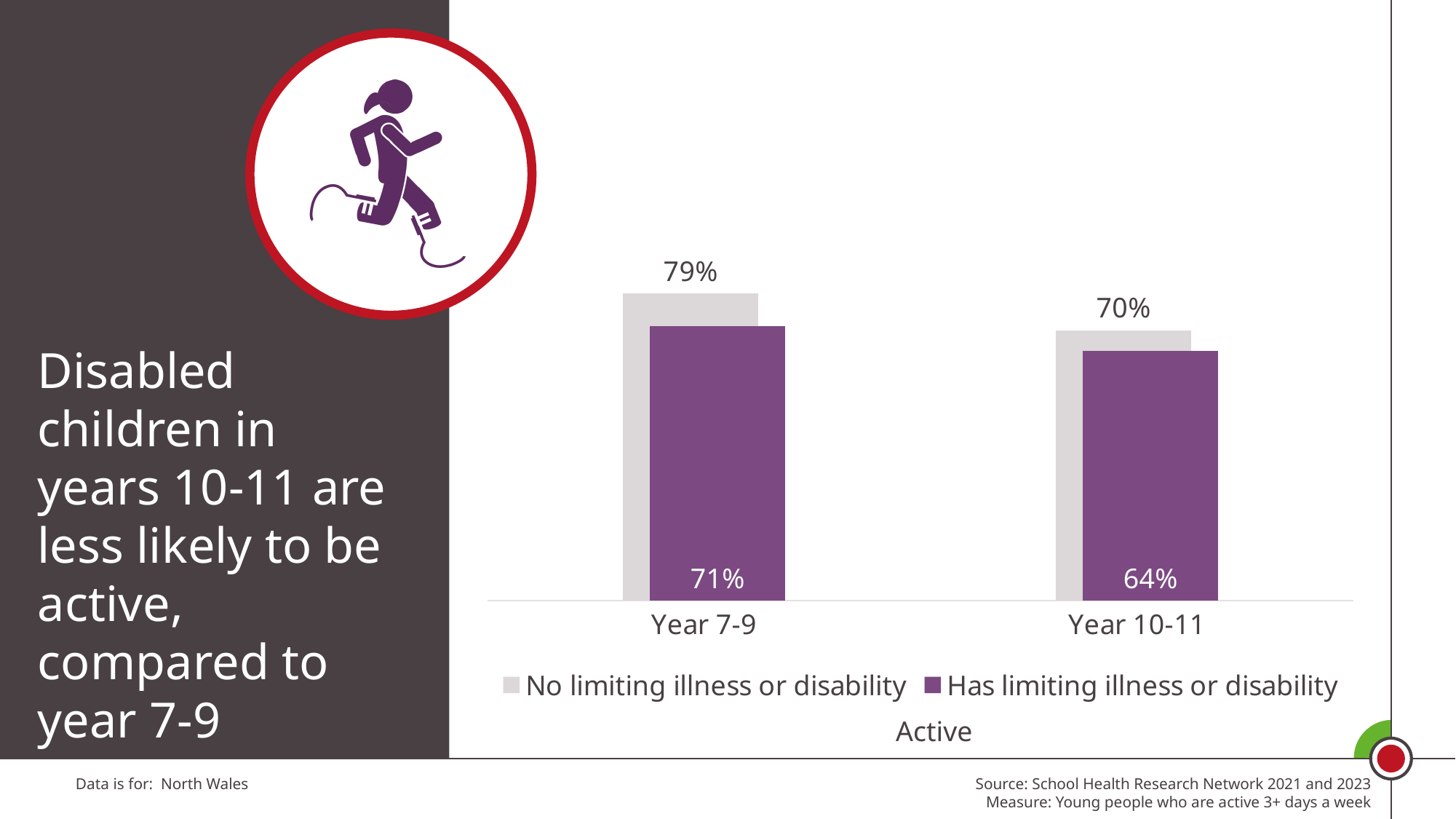
How many categories are shown on the x axis? 2 What kind of chart is shown on the slide? Bar chart What is the difference between 'No limiting illness or disability' and 'Has limiting illness or disability' in Year 10-11? 6% What is the value for 'No limiting illness or disability' in Year 7-9? 79% What is the value for 'No limiting illness or disability' in Year 10-11? 70% What is the value for 'Has limiting illness or disability' in Year 10-11? 64% Which category has the lowest value for 'No limiting illness or disability'? Year 10-11 What is the difference between 'No limiting illness or disability' and 'Has limiting illness or disability' in Year 7-9? 8% Which category has the highest value for 'Has limiting illness or disability'? Year 7-9 What is the value for 'Has limiting illness or disability' in Year 7-9? 71% Which is larger: 'Has limiting illness or disability' in Year 7-9 or 'No limiting illness or disability' in Year 10-11? Has limiting illness or disability in Year 7-9 How many series does the legend list? 2